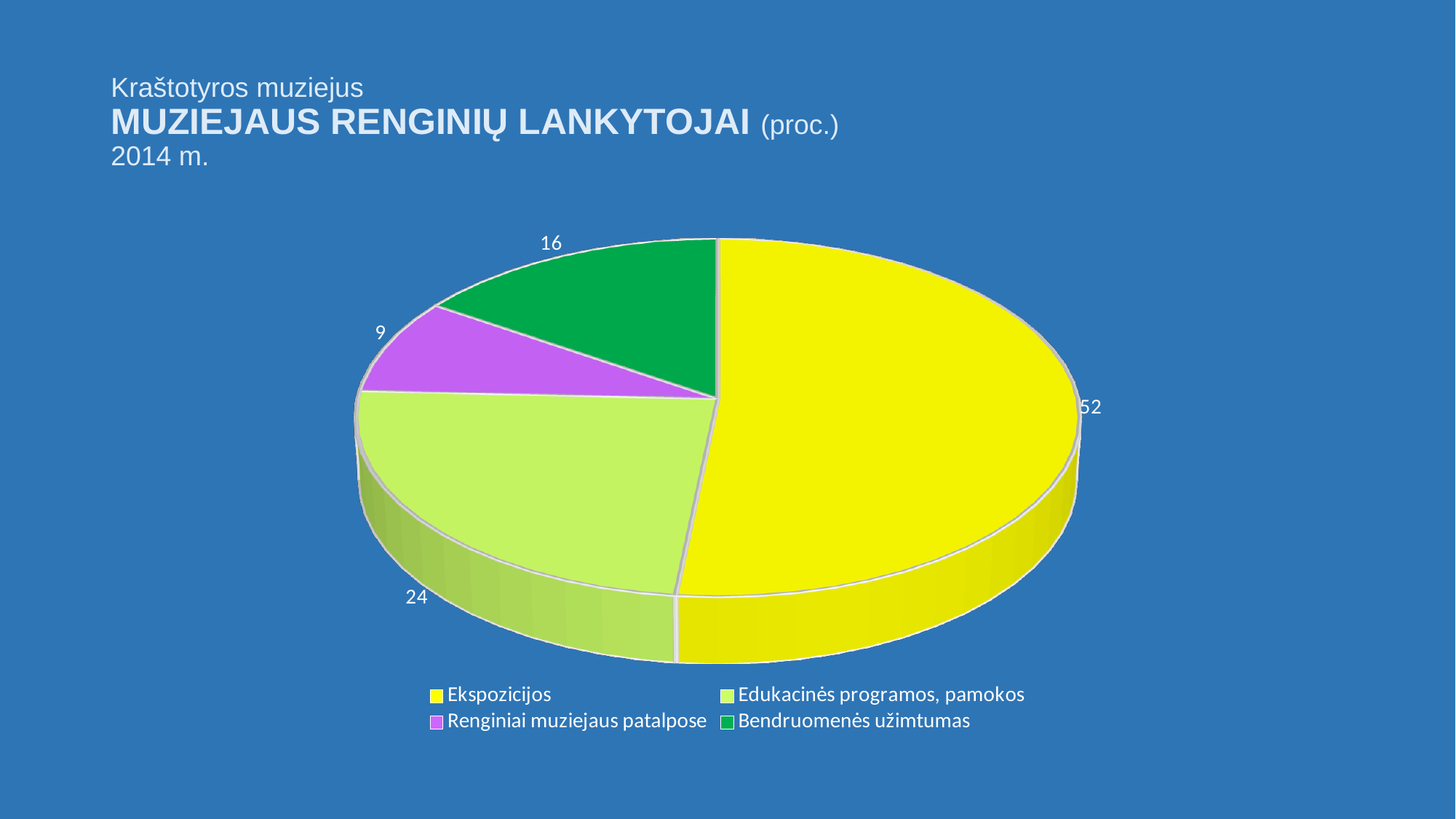
What is the value for Bendruomenės užimtumas? 16 Which is larger, Bendruomenės užimtumas or Renginiai muziejaus patalpose? Bendruomenės užimtumas What is the value for Ekspozicijos? 52 Which category has the largest slice? Ekspozicijos What year does the chart title refer to? 2014 m. What is the value for Renginiai muziejaus patalpose? 9 What is the value for Edukacinės programos, pamokos? 24 What colour is the Ekspozicijos slice? Yellow Which category has the smallest slice? Renginiai muziejaus patalpose What kind of chart is shown on the slide? Pie chart How many categories does the pie chart show? 4 What is the difference between the values for Ekspozicijos and Edukacinės programos, pamokos? 28